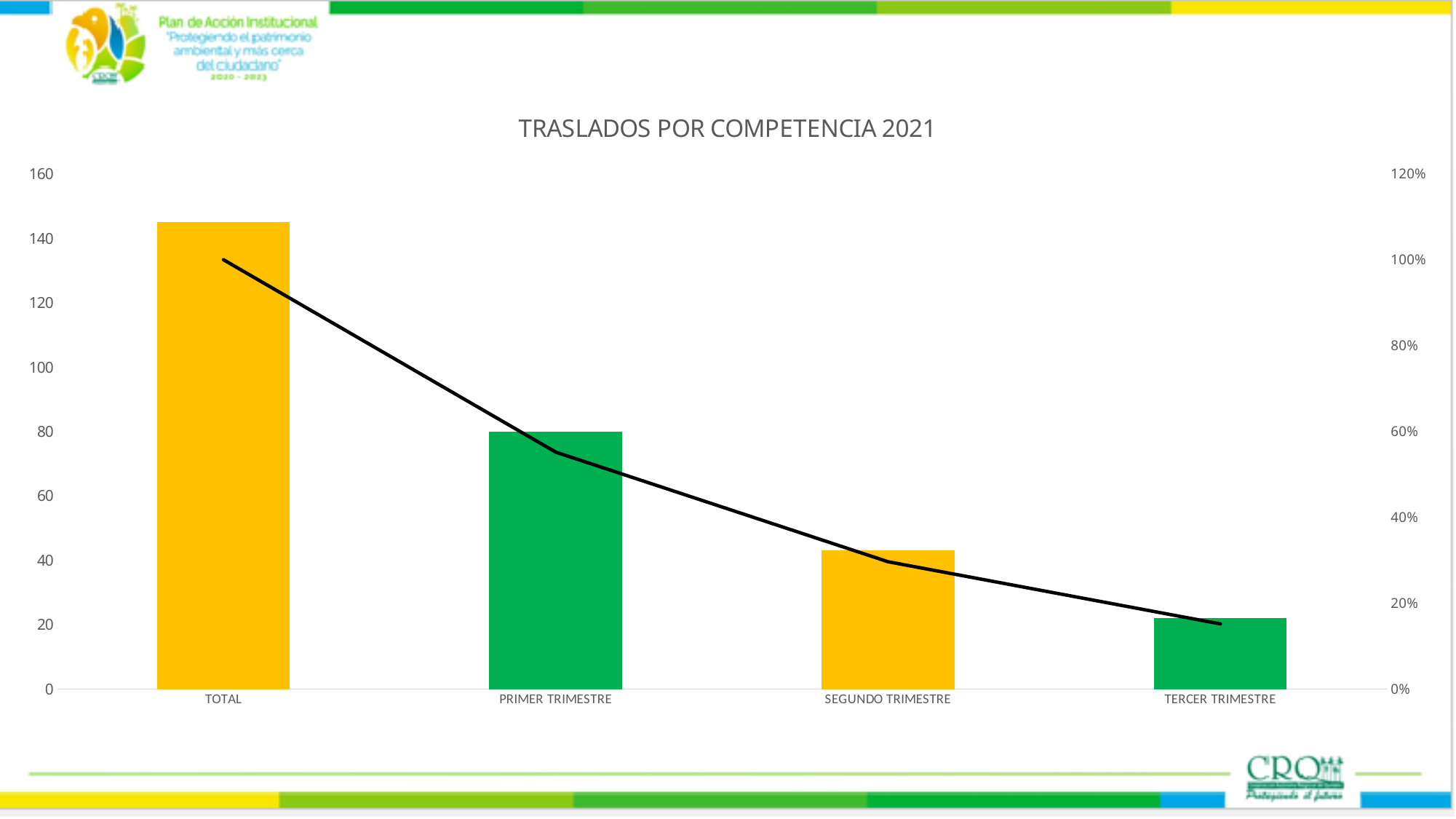
What is the value of the line at TOTAL on the right-hand percentage axis? 100% What is the title of the chart? TRASLADOS POR COMPETENCIA 2021 Is the bar for SEGUNDO TRIMESTRE greater or less than 60? less Does the line rise or fall from TOTAL to TERCER TRIMESTRE? fall What colour is the bar for PRIMER TRIMESTRE? Green Which bar is taller, PRIMER TRIMESTRE or SEGUNDO TRIMESTRE? PRIMER TRIMESTRE Is the bar for TOTAL greater or less than 140? greater Which category has the lowest bar in the chart? TERCER TRIMESTRE What kind of chart is shown on the slide? Bar chart with a line Is the bar for TERCER TRIMESTRE greater or less than 40? less Which category has the highest bar in the chart? TOTAL How many categories are shown on the x axis of the chart? 4